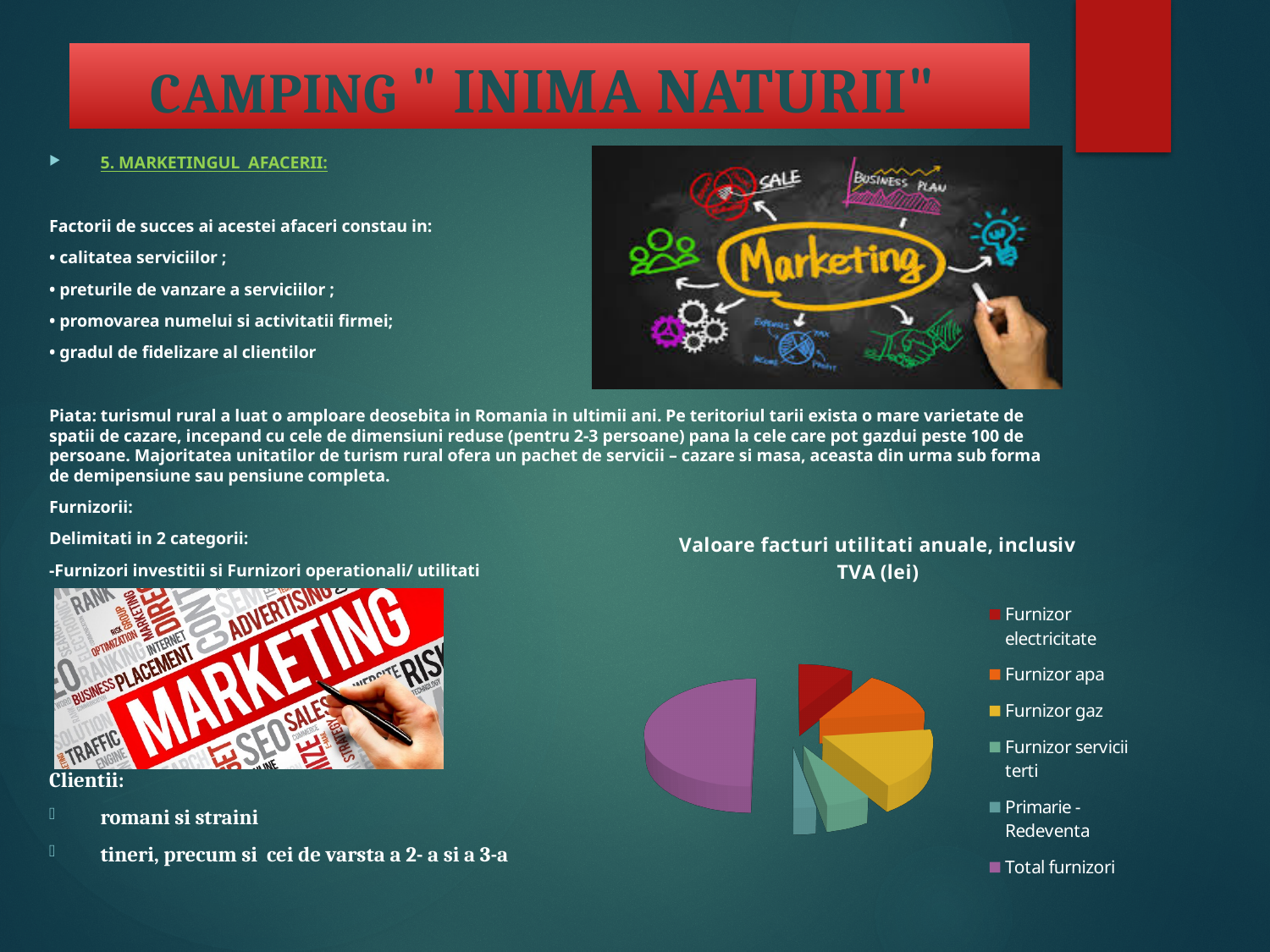
What colour is the Total furnizori slice in the pie chart? purple Which legend entry is listed last in the pie chart's legend? Total furnizori What is the title of the pie chart? Valoare facturi utilitati anuale, inclusiv TVA (lei) In the pie chart, which is larger: Total furnizori or Furnizor apa? Total furnizori In the pie chart, which is larger: Total furnizori or Furnizor electricitate? Total furnizori In the pie chart, which is larger: Furnizor gaz or Furnizor servicii terti? Furnizor gaz Which category has the largest slice in the pie chart? Total furnizori Which legend entry is listed first in the pie chart's legend? Furnizor electricitate What kind of chart is shown on the slide? pie chart How many categories does the legend of the pie chart list? 6